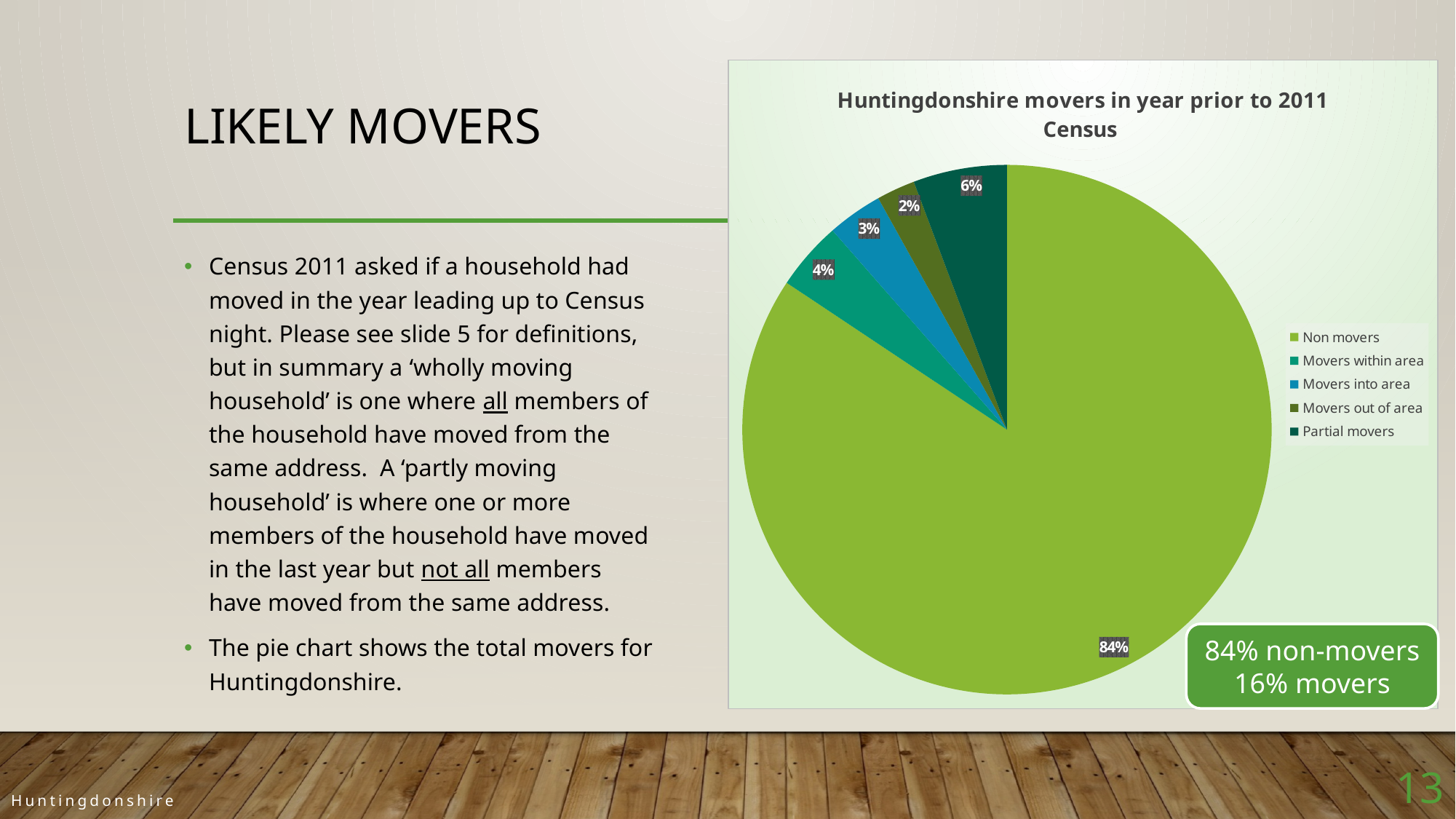
What share of the pie is Movers within area? 4% Which category has the smallest slice of the pie? Movers out of area Which is larger, the slice for Movers into area or the slice for Partial movers? Partial movers What share of the pie is Non movers? 84% What share of the pie is Movers out of area? 2% Which category has the largest slice of the pie? Non movers What is the title of the chart? Huntingdonshire movers in year prior to 2011 Census How many categories does the legend list? 5 What is the difference in percentage points between Partial movers and Movers within area? 2 What type of chart is shown on the slide? pie chart